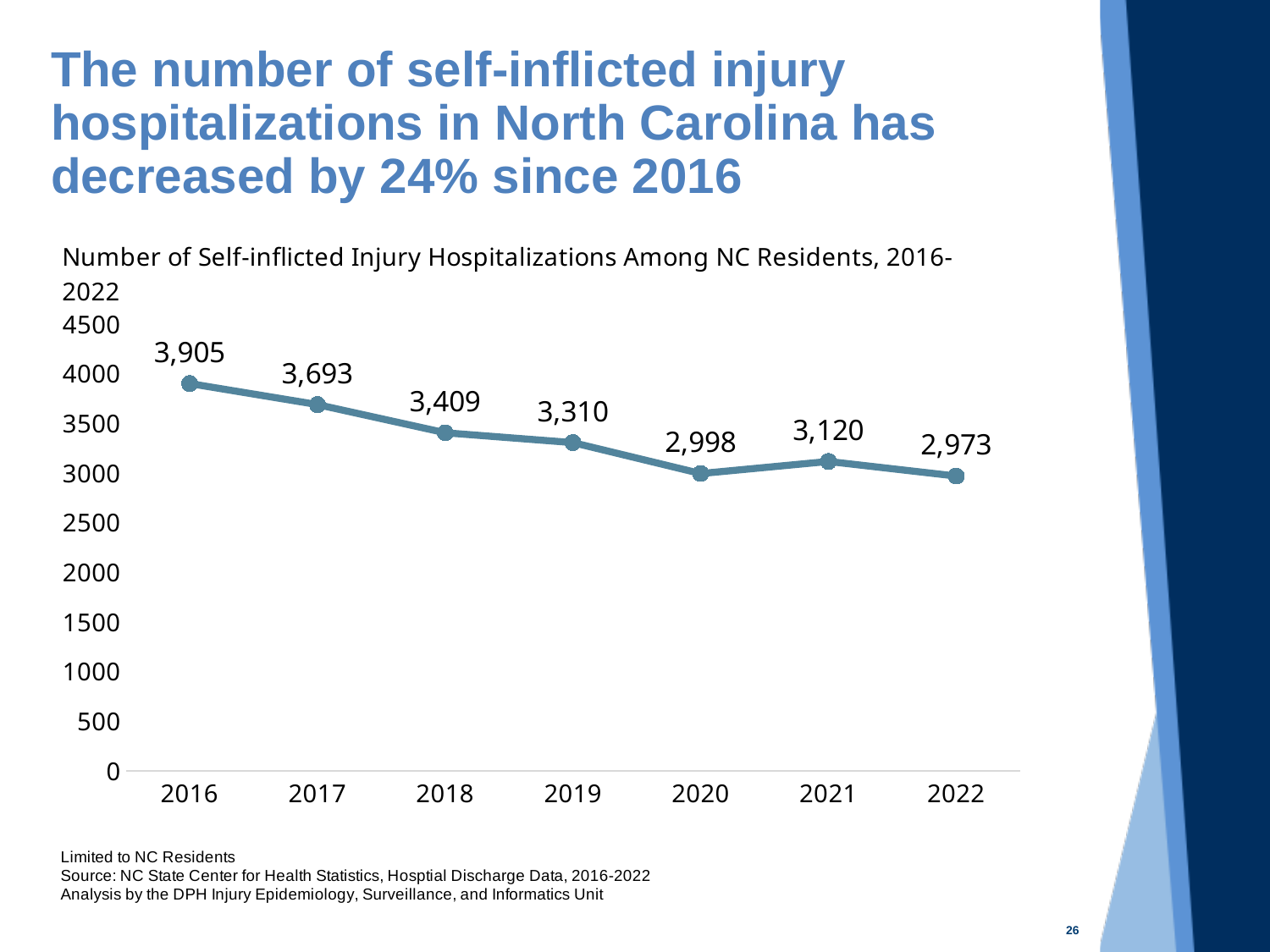
Which year had more hospitalizations, 2018 or 2019? 2018 Which year had the highest number of self-inflicted injury hospitalizations? 2016 What is the difference between the 2020 and 2021 values? 122 How many years are plotted on the chart? 7 What was the number of self-inflicted injury hospitalizations in 2020? 2,998 Is the value for 2017 greater or less than 3500? greater What is the difference between the 2016 and 2022 values? 932 What was the number of self-inflicted injury hospitalizations in 2016? 3,905 What type of chart is shown on the slide? Line chart Which year had the lowest number of self-inflicted injury hospitalizations? 2022 What was the number of self-inflicted injury hospitalizations in 2022? 2,973 What is the overall trend in hospitalizations from 2016 to 2022? Decreasing